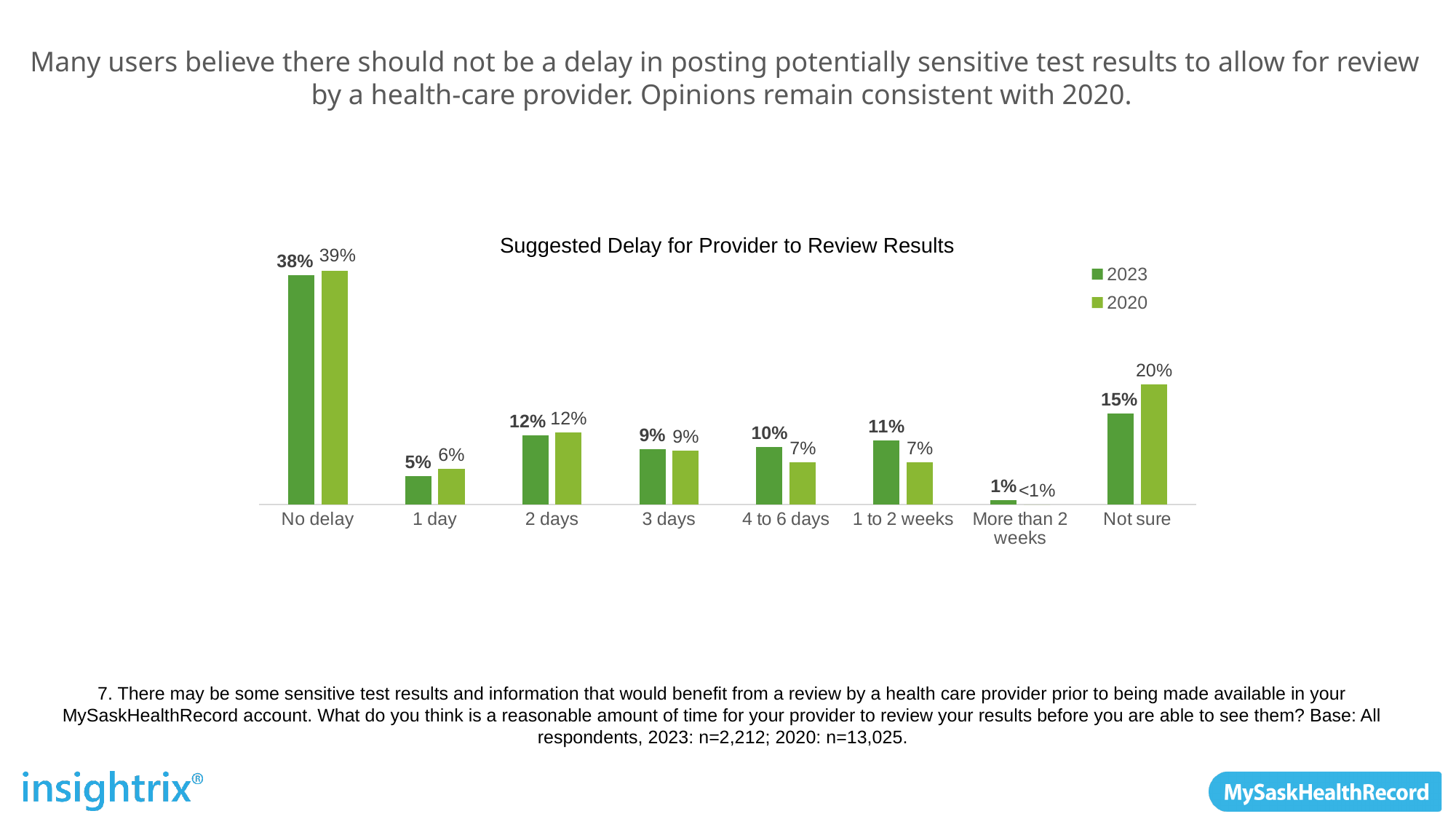
What is the 2023 value for "No delay"? 38% How many categories are shown on the x axis? 8 What kind of chart is shown? Bar chart Which category has the lowest 2020 value? More than 2 weeks What is the 2023 value for "1 to 2 weeks"? 11% For "4 to 6 days", which year has the larger value, 2023 or 2020? 2023 Which category has the highest 2023 value? No delay How many series does the legend list? 2 What is the 2020 value for "Not sure"? 20% What is the 2020 value for "More than 2 weeks"? <1% What is the title of the chart? Suggested Delay for Provider to Review Results What is the difference between the 2020 and 2023 values for "Not sure"? 5%